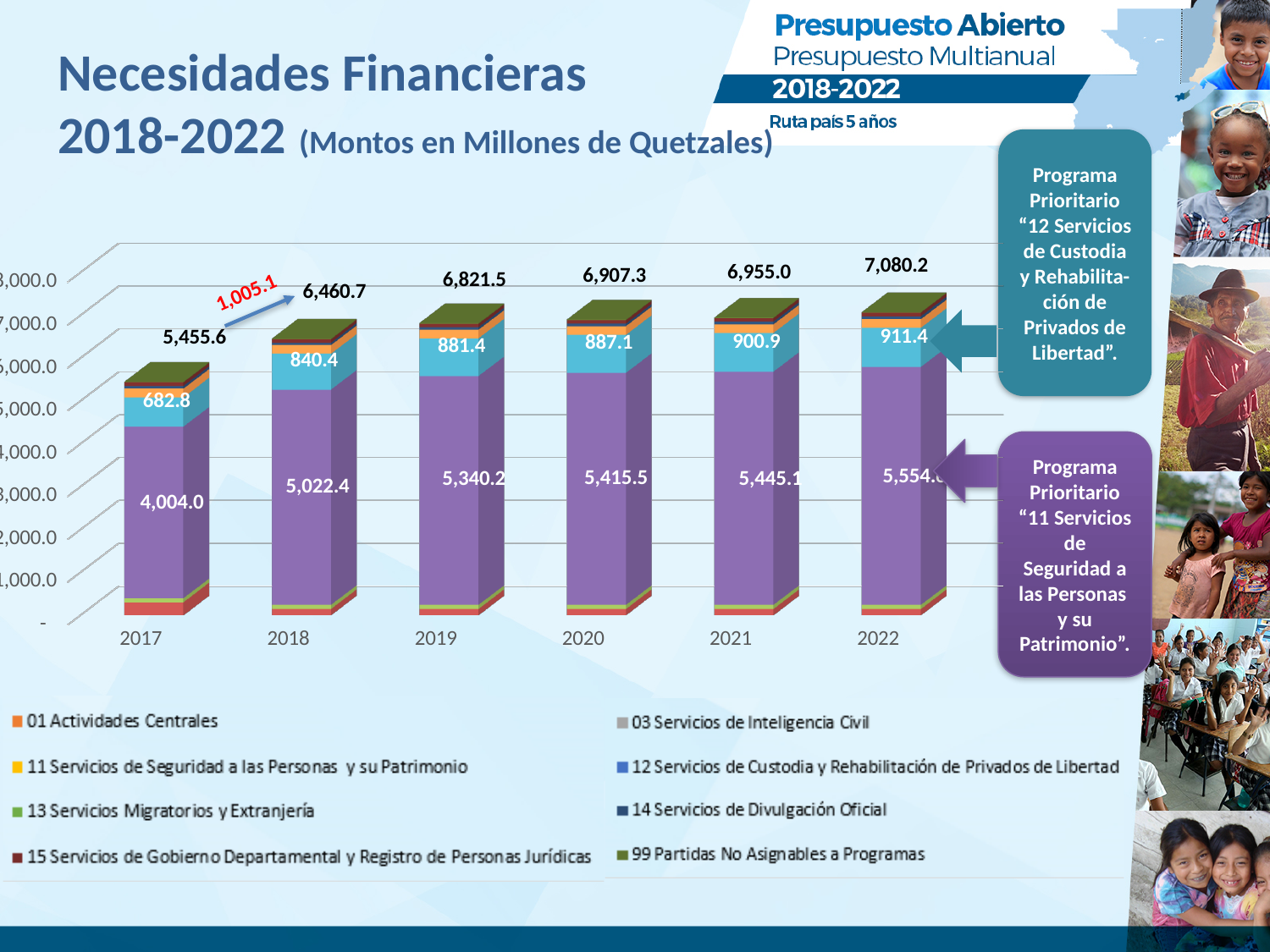
Which year has the highest total financial need? 2022 What is the value for the program "11 Servicios de Seguridad a las Personas y su Patrimonio" in 2018? 5,022.4 What is the difference between the total for 2022 and the total for 2021? 125.2 By how much did the total financial need increase from 2017 to 2018? 1,005.1 How many years are shown on the x axis of the chart? 6 What is the total financial need shown for 2019? 6,821.5 What kind of chart is shown on the slide? Stacked bar chart Do the total financial needs rise or fall from 2017 to 2022? Rise Which year has the lowest total financial need? 2017 Which year has the larger total, 2019 or 2020? 2020 How many series does the legend list? 8 What is the value for the program "12 Servicios de Custodia y Rehabilitación de Privados de Libertad" in 2020? 887.1